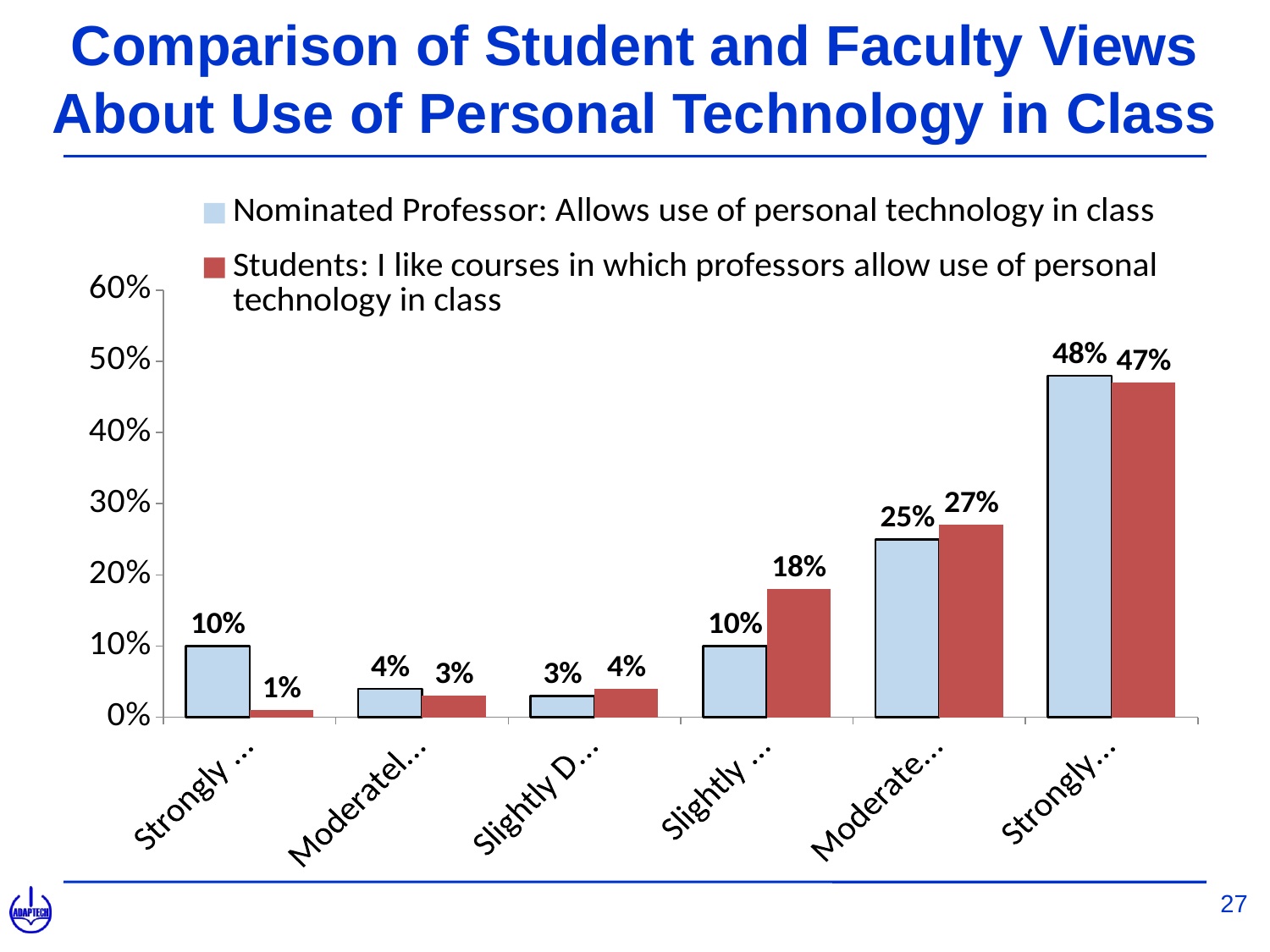
In the leftmost category, which series has the larger value? Nominated Professor Is the Students value for the fifth category from the left greater or less than 20%? greater Do the Students values generally rise or fall from left to right across the categories? Rise What is the highest value shown for the Students series? 47% How many series does the legend list? 2 What is the Students value for the leftmost category? 1% In the fourth category from the left, how much higher is the Students value than the Nominated Professor value? 8 percentage points What kind of chart is shown on the slide? Bar chart What is the Students value for the fourth category from the left? 18% What is the Nominated Professor value for the rightmost category? 48% What is the lowest value shown for the Nominated Professor series? 3% How many categories are plotted along the x axis? 6